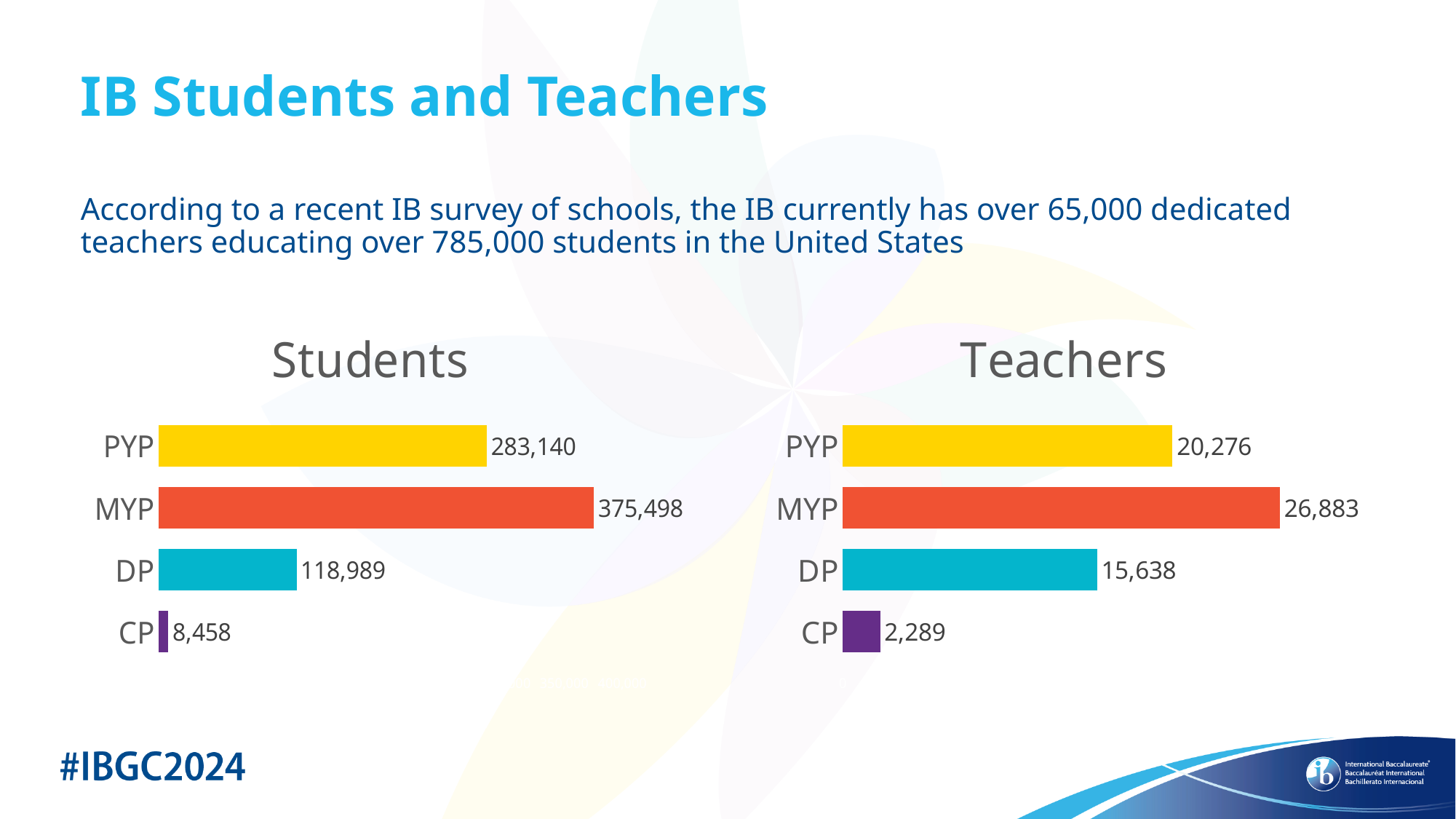
In the Teachers chart, what is the value for PYP? 20,276 In the Students chart, what is the value for CP? 8,458 How many categories are shown in the Students chart? 4 In the Teachers chart, which is larger: the value for PYP or the value for DP? PYP In the Students chart, which programme has the highest number of students? MYP In the Teachers chart, which programme has the lowest number of teachers? CP In the Students chart, what is the value for MYP? 375,498 In the Teachers chart, what is the value for DP? 15,638 In the Teachers chart, what is the difference between the MYP and DP values? 11,245 In the Students chart, what is the difference between the MYP and PYP values? 92,358 In the Students chart, what colour is the DP bar? Teal What type of chart is the Teachers chart? Bar chart